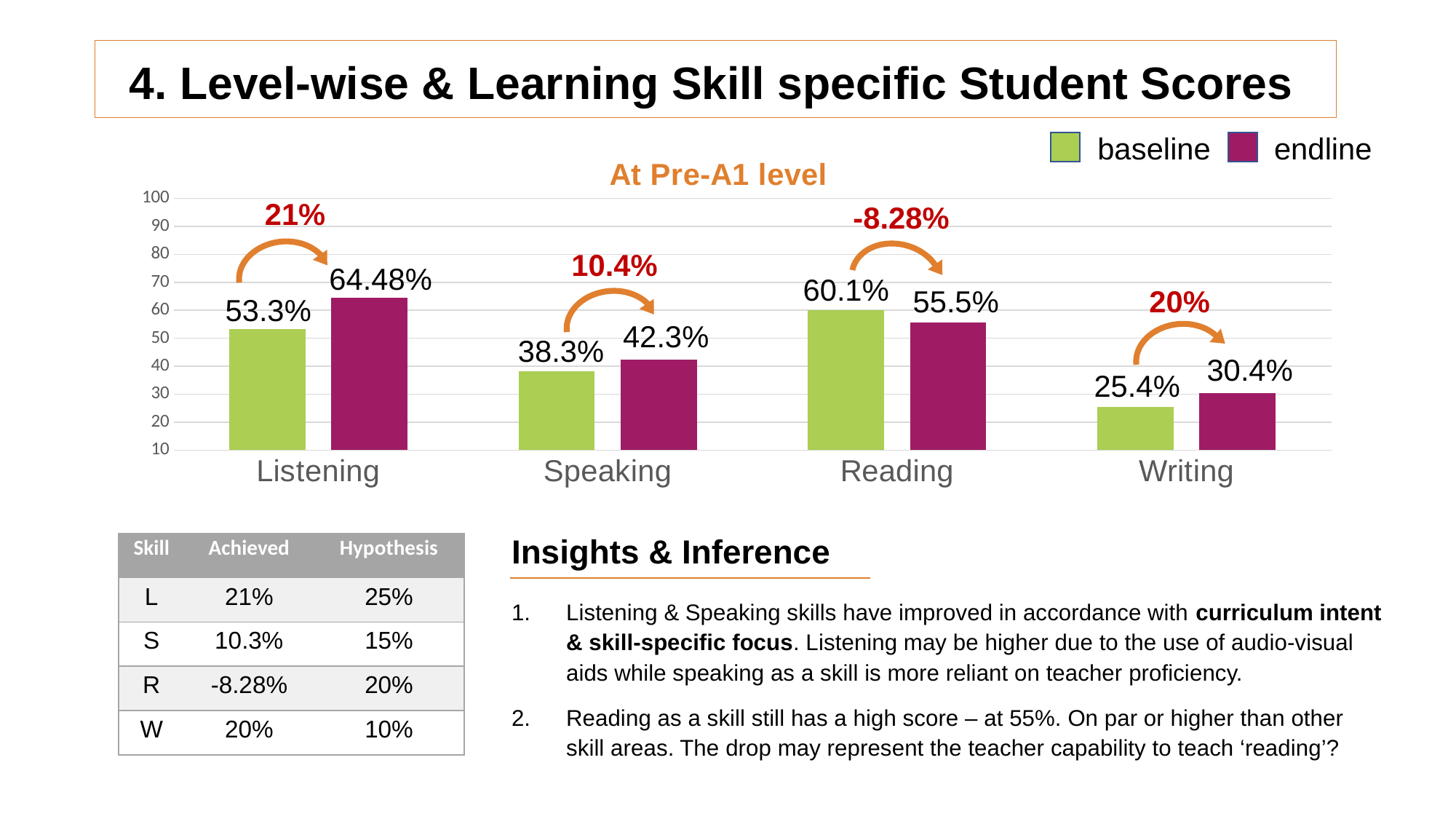
Which skill has the lowest baseline value? Writing What is the difference between the endline and baseline values for Speaking? 4.0% What kind of chart is shown on the slide? Bar chart What is the title shown above the chart? At Pre-A1 level Is the endline value for Listening greater or less than 60? greater Is the baseline value for Reading larger than the endline value for Reading? Yes How many series does the legend list? 2 What is the endline value for Reading? 55.5% What is the endline value for Writing? 30.4% How many skill categories are shown on the x axis? 4 Which skill has the highest endline value? Listening What is the baseline value for Listening? 53.3%